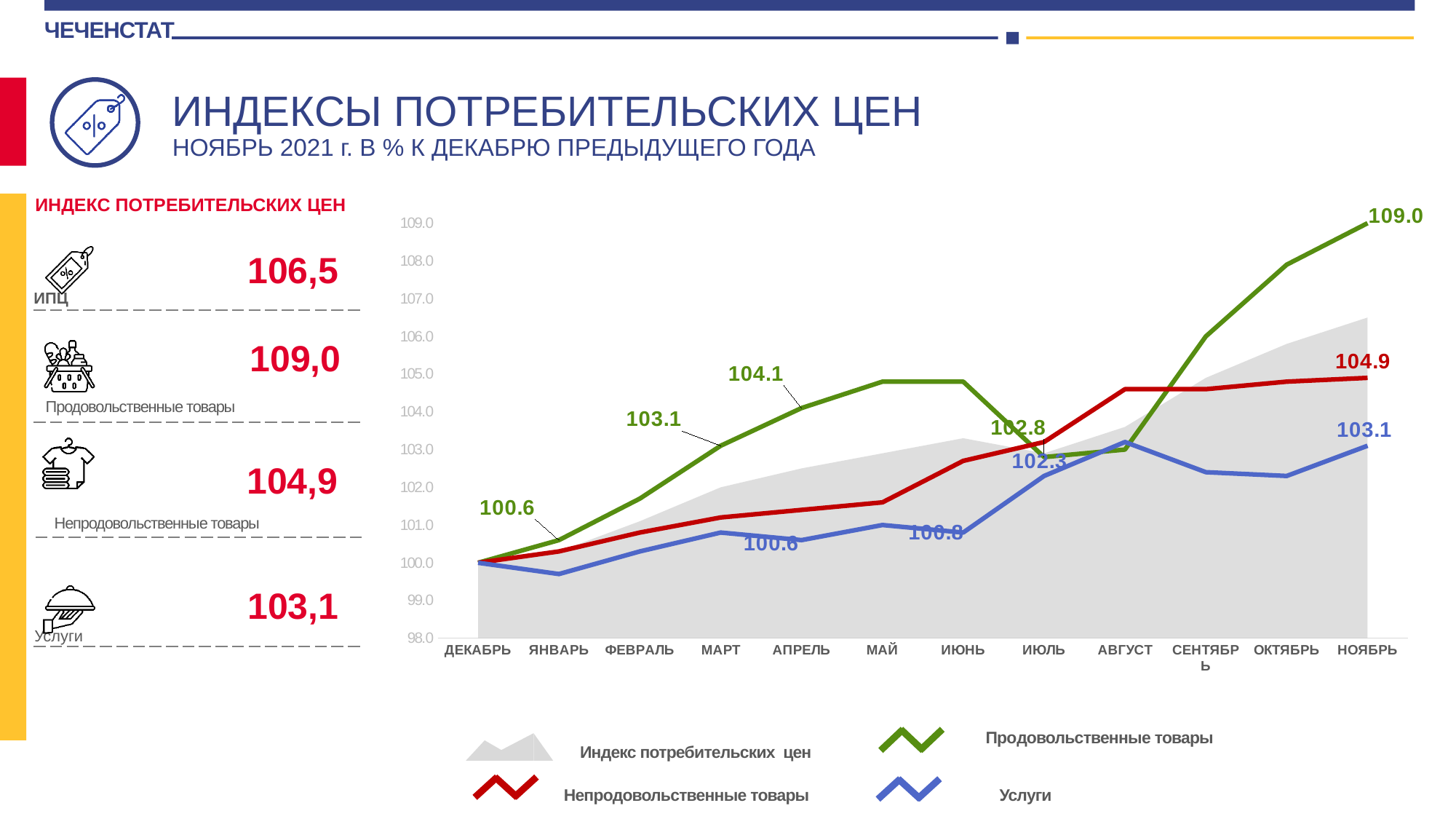
Which series has the highest value in НОЯБРЬ? Продовольственные товары What is the difference between Продовольственные товары and Услуги in НОЯБРЬ? 5.9 Is the value for Продовольственные товары in СЕНТЯБРЬ greater or less than 105.0? greater What is the value of Продовольственные товары in АПРЕЛЬ? 104.1 What type of chart is shown on the slide? combination area and line chart What is the value of Продовольственные товары in НОЯБРЬ? 109.0 What colour is the line for Услуги? blue How many series does the chart legend list? 4 What is the value of Услуги in НОЯБРЬ? 103.1 What is the value of Непродовольственные товары in НОЯБРЬ? 104.9 What is the value of Продовольственные товары in МАРТ? 103.1 How many months are shown along the x axis of the chart? 12